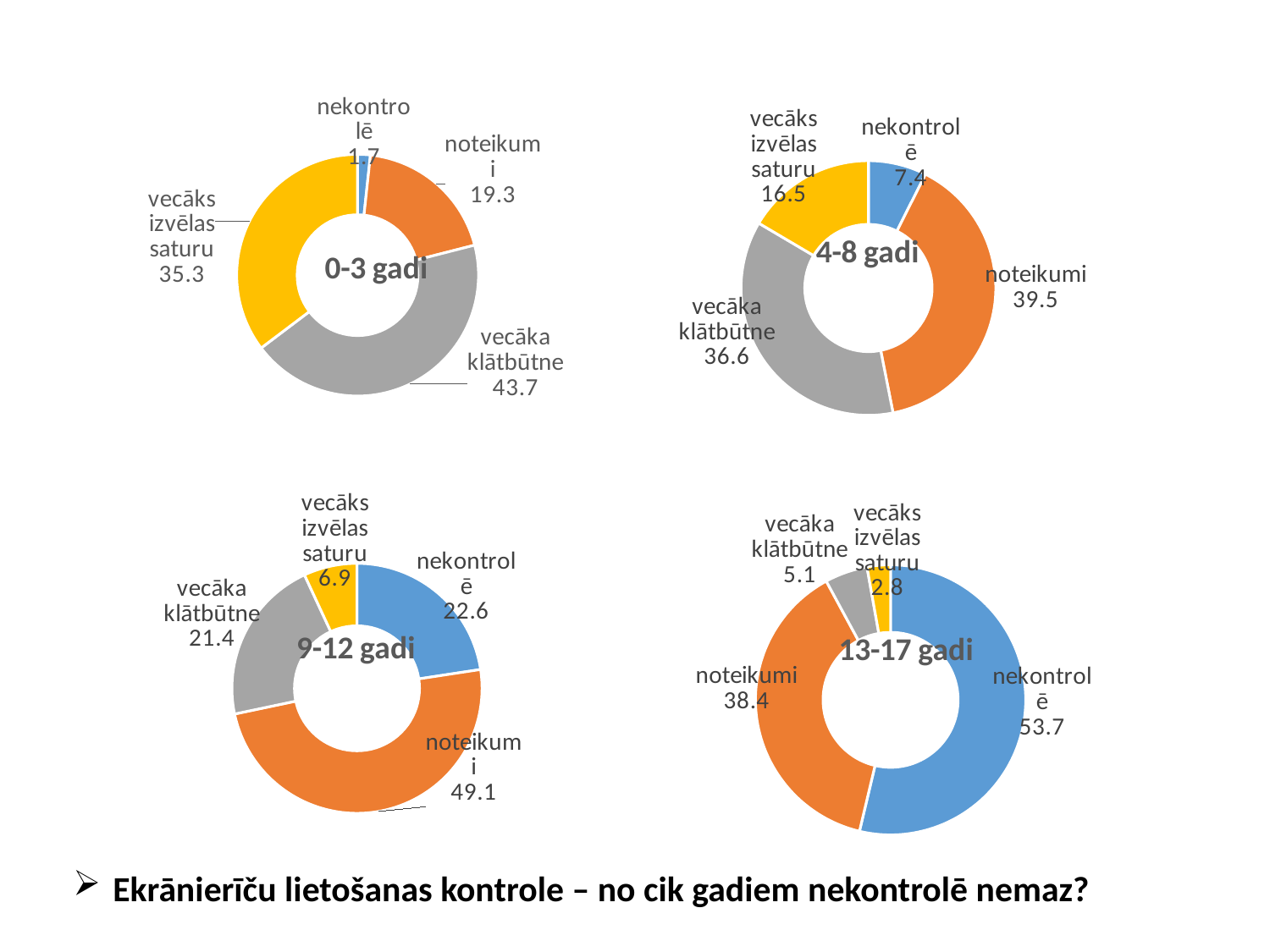
In the "9-12 gadi" chart, what is the value for "vecāks izvēlas saturu"? 6.9 In the "4-8 gadi" chart, what is the value for "nekontrolē"? 7.4 In the "9-12 gadi" chart, which category has the largest value? noteikumi In the "13-17 gadi" chart, what is the value for "noteikumi"? 38.4 In the "13-17 gadi" chart, which category has the largest value? nekontrolē In the "0-3 gadi" chart, which category has the smallest value? nekontrolē In the "13-17 gadi" chart, what is the difference between "nekontrolē" and "noteikumi"? 15.3 In the "0-3 gadi" chart, what is the value for "vecāka klātbūtne"? 43.7 Which is larger in the "0-3 gadi" chart: "vecāks izvēlas saturu" or "noteikumi"? vecāks izvēlas saturu How many categories does the "9-12 gadi" chart show? 4 In the "4-8 gadi" chart, what is the difference between "noteikumi" and "vecāks izvēlas saturu"? 23.0 What kind of chart is the "4-8 gadi" chart? doughnut chart